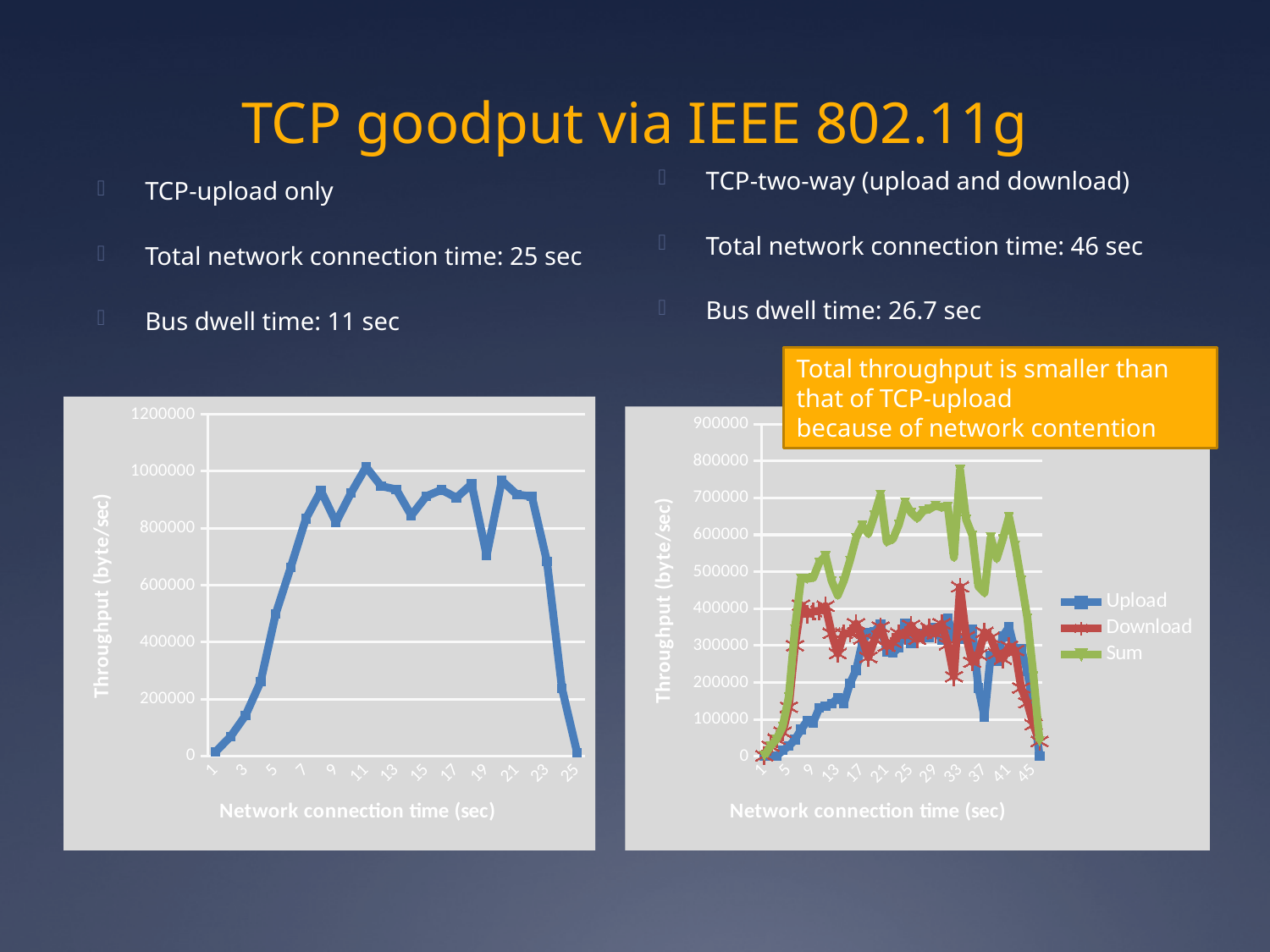
In the left chart, do the values rise or fall between network connection time 1 sec and 7 sec? rise In the left chart, do the values rise or fall between network connection time 23 sec and 25 sec? fall What kind of chart is the left chart (TCP-upload only)? line chart What are the series names in the legend of the right chart? Upload, Download, Sum In the right chart, at network connection time 9 sec, which is larger, the Upload value or the Download value? Download In the left chart, is the value at network connection time 5 sec greater or less than 400000? greater In the left chart, is the value at network connection time 19 sec greater or less than 600000? greater In the right chart, which series reaches the highest value? Sum In the left chart, is the value at network connection time 11 sec greater or less than 800000? greater How many series does the legend of the right chart (TCP-two-way) list? 3 What is the y-axis title of the left chart? Throughput (byte/sec)